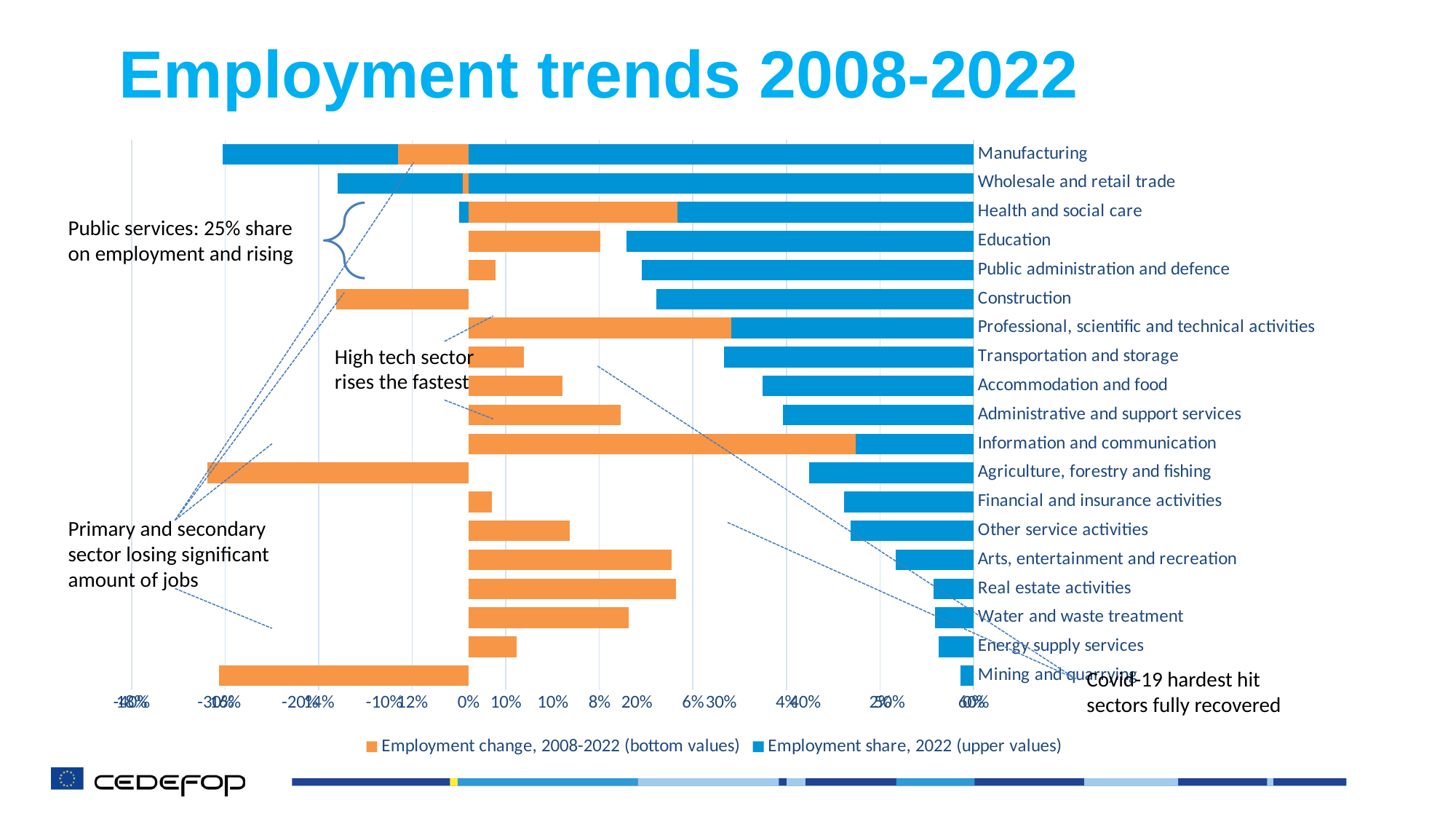
What is the title of the slide's chart? Employment trends 2008-2022 How many series does the legend list? 2 Which sector shows the largest positive employment change over 2008-2022? Information and communication Which has the larger employment change 2008-2022: Health and social care or Education? Health and social care Which has the larger employment share in 2022: Manufacturing or Wholesale and retail trade? Manufacturing Which sector shows the largest negative employment change over 2008-2022? Agriculture, forestry and fishing Which sector has the smallest employment share in 2022? Mining and quarrying How many sectors (categories) are plotted in the chart? 19 Is the employment change 2008-2022 for Construction positive or negative? Negative What type of chart is shown on the slide? Bar chart Which sector has the largest employment share in 2022? Manufacturing Which colour represents the 'Employment share, 2022' series? Blue